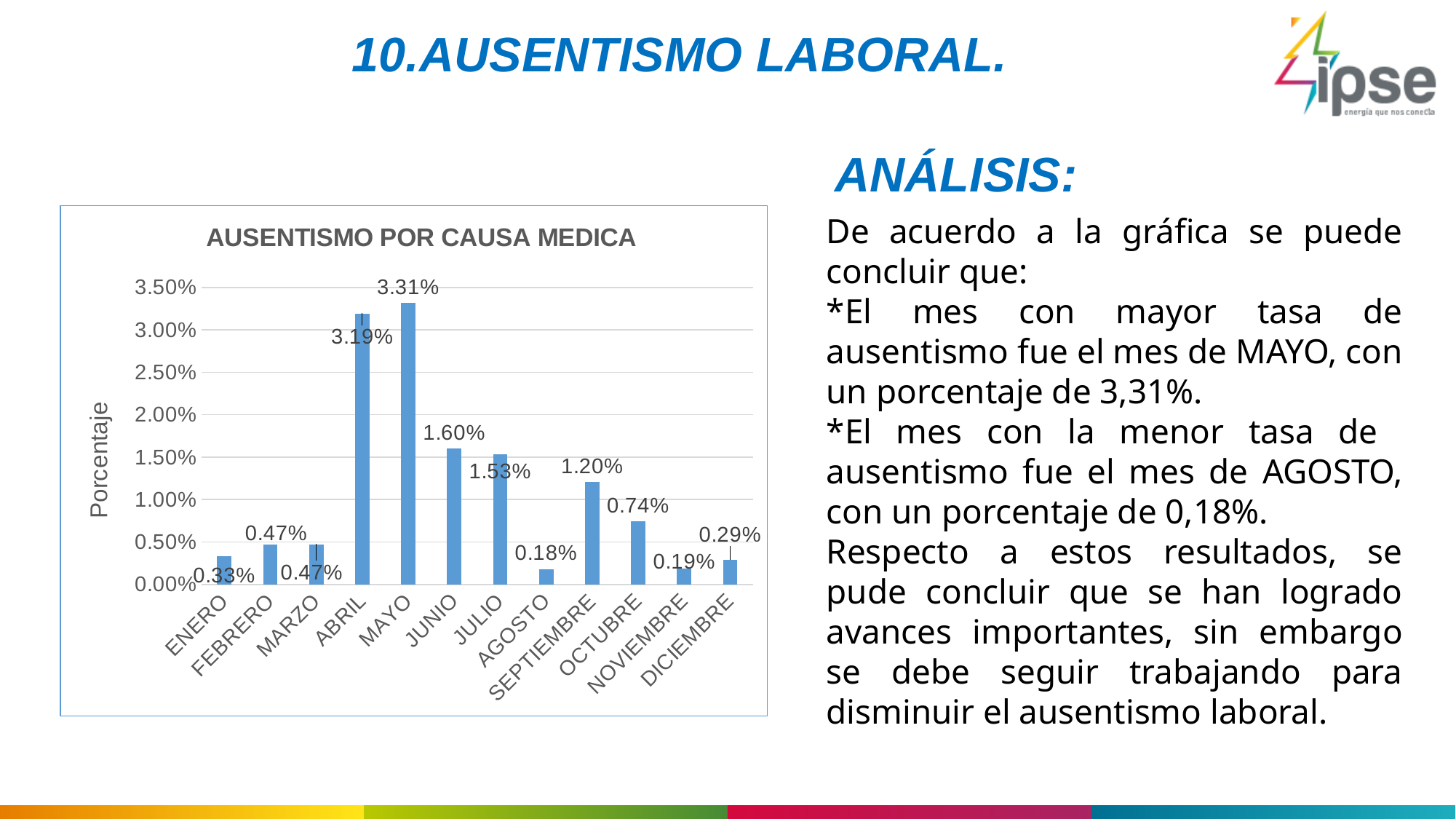
What is the difference between the values for JUNIO and JULIO? 0.07% What kind of chart is shown on the slide? bar chart Which month has the highest value in the chart? MAYO Is the value for SEPTIEMBRE greater or less than 1.00%? greater What is the title of the chart? AUSENTISMO POR CAUSA MEDICA What is the difference between the values for MAYO and ABRIL? 0.12% How many months are shown on the x axis of the chart? 12 What is the value for MAYO in the chart? 3.31% Which is larger, the value for OCTUBRE or the value for DICIEMBRE? OCTUBRE Which month has the lowest value in the chart? AGOSTO What is the value for SEPTIEMBRE in the chart? 1.20% What is the value for AGOSTO in the chart? 0.18%